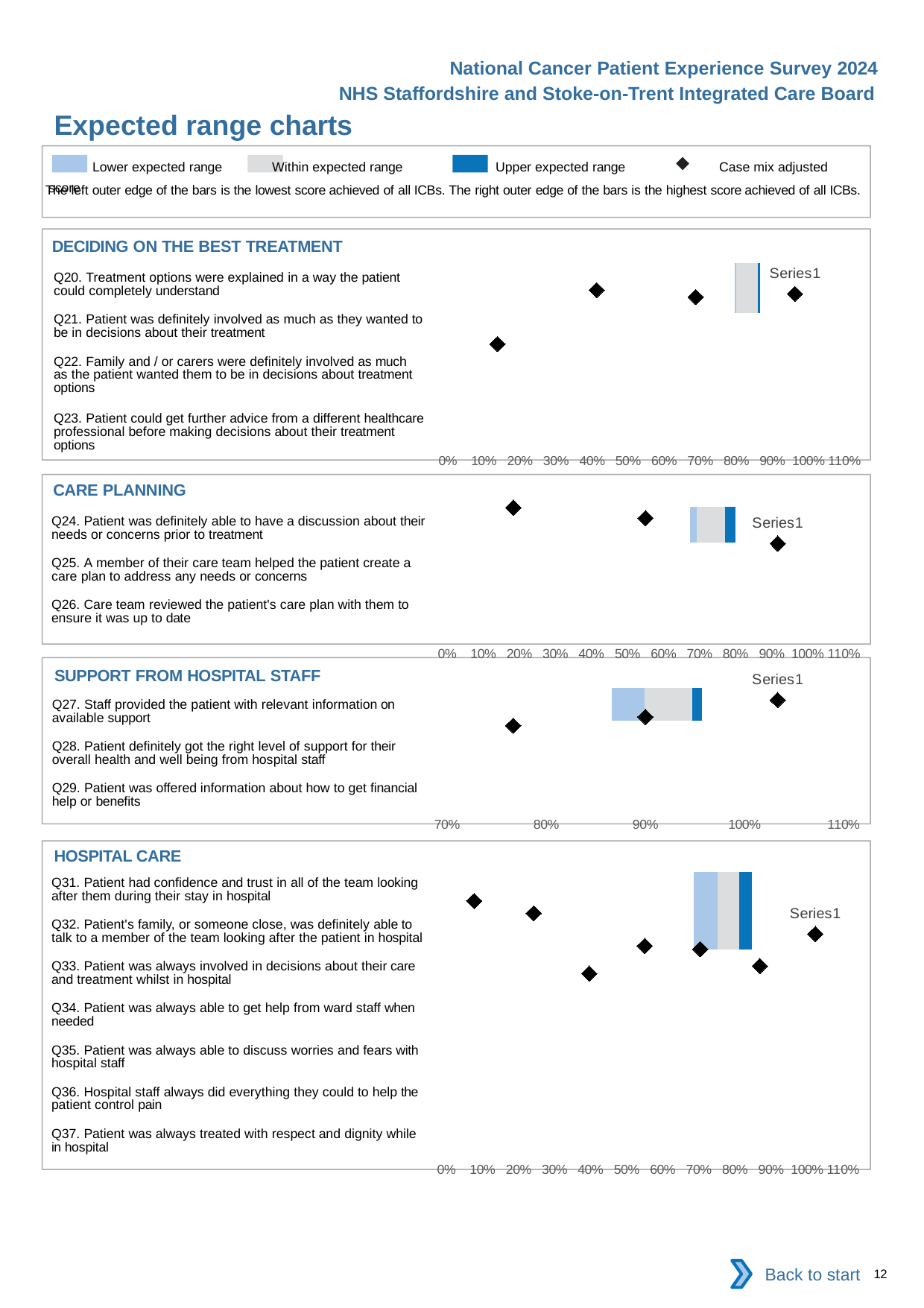
In the SUPPORT FROM HOSPITAL STAFF chart, what is the lowest value shown on the x axis? 70% In the CARE PLANNING chart, how many series does the legend list? 1 How many charts are shown on the slide? 4 In the CARE PLANNING chart, how many questions (categories) are listed? 3 In the HOSPITAL CARE chart, is the leftmost diamond marker greater or less than 20%? less In the HOSPITAL CARE chart, what is the highest tick shown on the x axis? 110% In the DECIDING ON THE BEST TREATMENT chart, is the leftmost diamond marker greater or less than 20%? less In the DECIDING ON THE BEST TREATMENT chart, how many diamond markers are plotted? 3 In the CARE PLANNING chart, is the leftmost diamond marker greater or less than 30%? less What kind of chart is the CARE PLANNING chart? bar chart